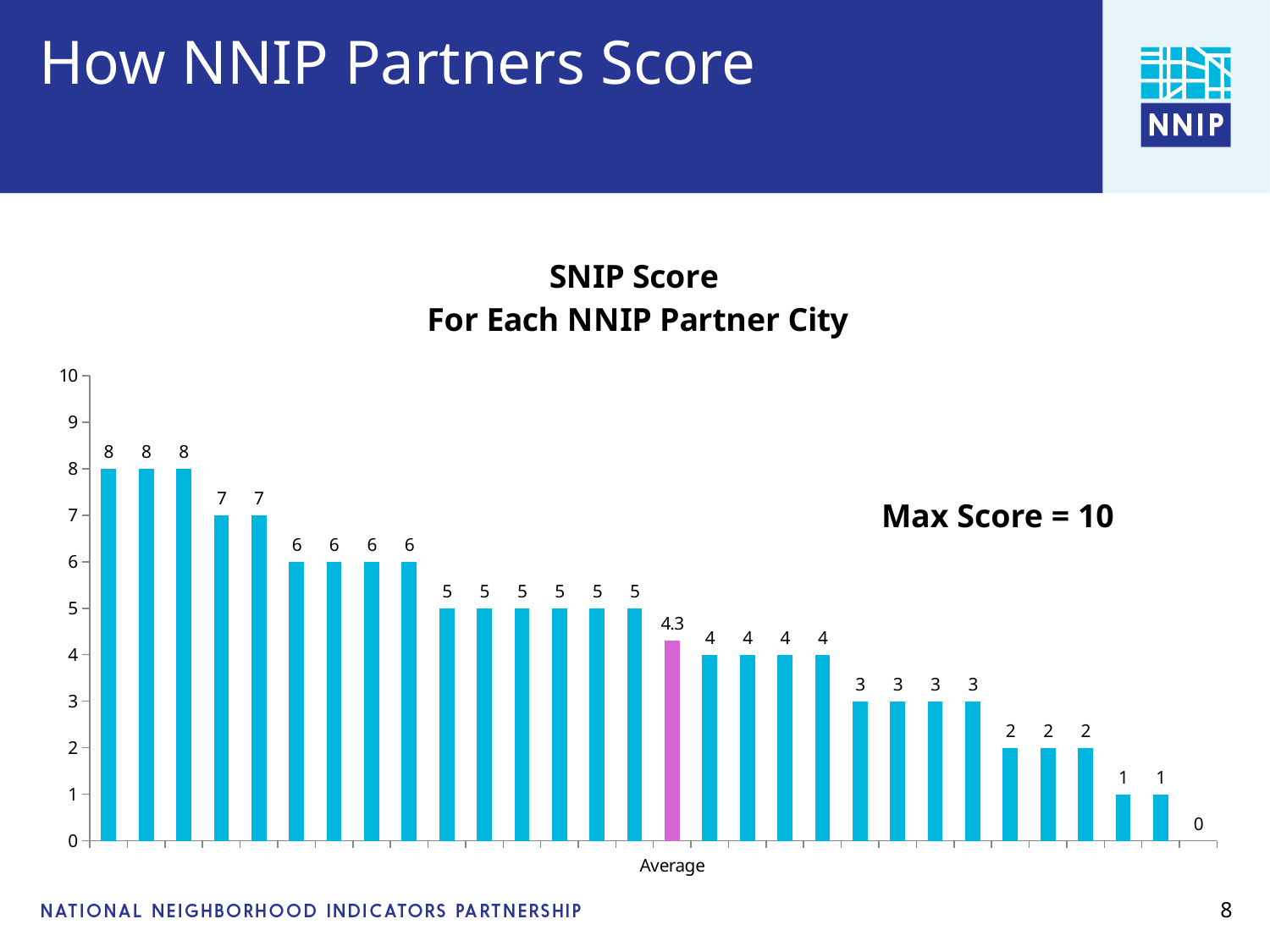
What colour is the Average bar, compared with the other bars? pink (the others are blue) What is the value of the Average bar? 4.3 What is the lowest SNIP score shown in the chart? 0 What is the difference between the highest score (8) and the Average bar (4.3)? 3.7 What is the highest SNIP score shown in the chart? 8 How many bars are plotted in the chart, including the Average bar? 30 Is the value of the Average bar greater or less than 4? greater According to the text on the chart, what is the maximum possible score? 10 What kind of chart is shown on the slide? bar chart How many bars have a score of 5? 6 How many bars have a score of 8? 3 Do the bar values rise or fall from left to right along the x axis? fall